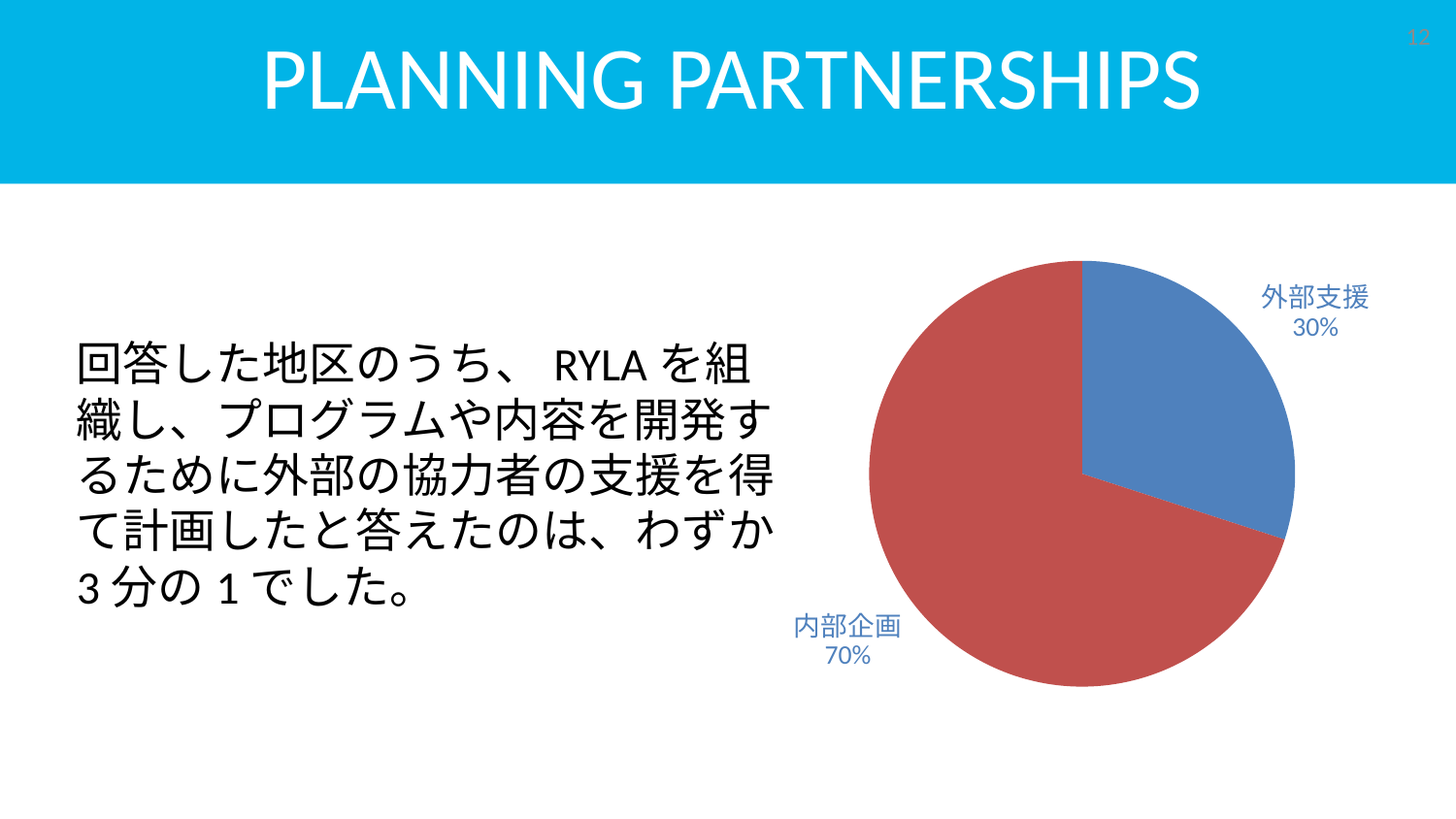
What kind of chart is shown on the slide? Pie chart How many slices does the pie chart have? 2 Which slice of the pie chart is the largest? 内部企画 Which is larger, the share for 内部企画 or the share for 外部支援? 内部企画 What colour is the 外部支援 slice of the pie chart? Blue What share of the pie does 内部企画 represent? 70% What share of the pie does 外部支援 represent? 30% Is the share for 外部支援 greater or less than 50%? less What colour is the 内部企画 slice of the pie chart? Red Which slice of the pie chart is the smallest? 外部支援 What is the difference in percentage points between 内部企画 and 外部支援? 40